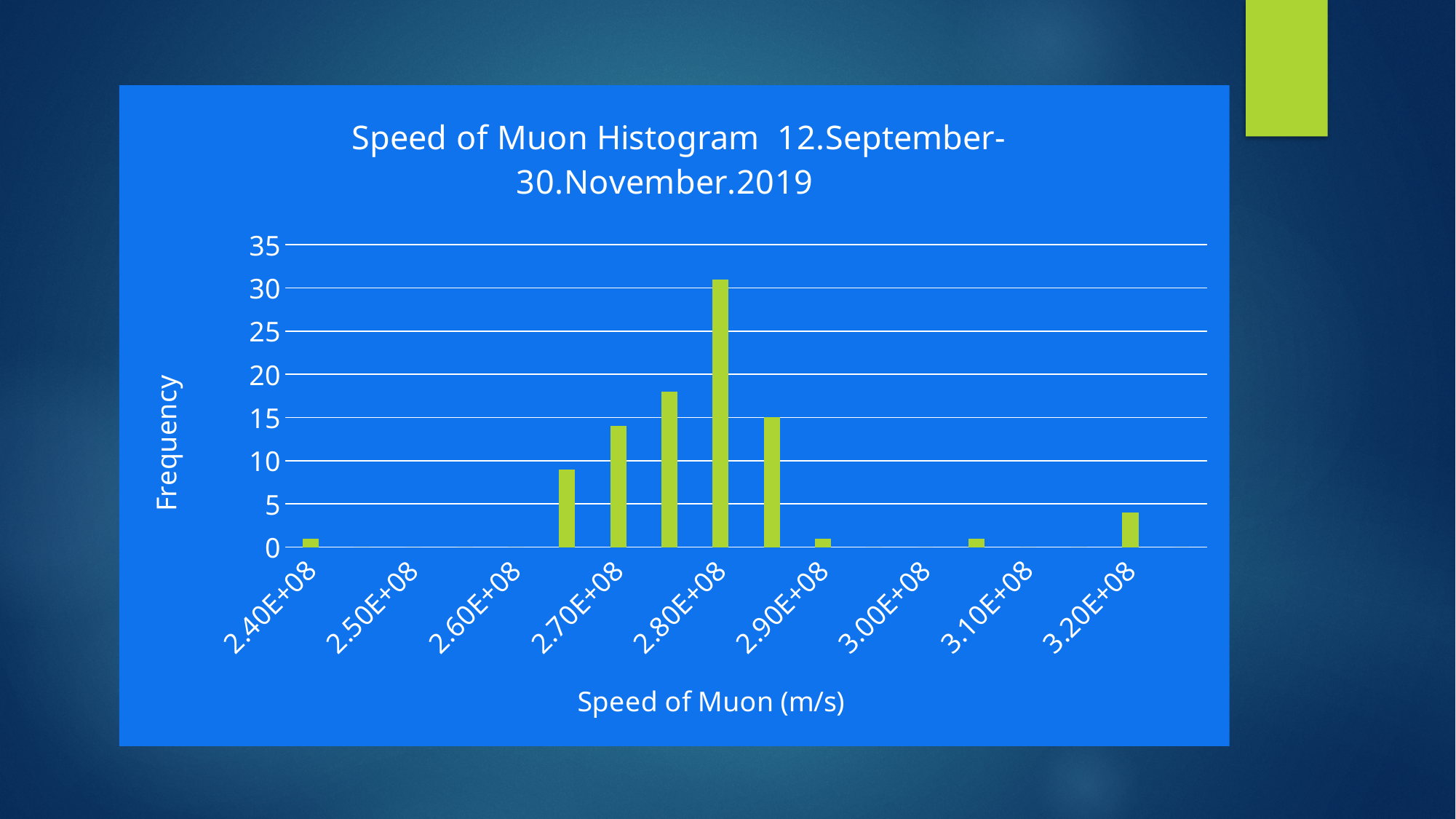
Which has a higher frequency, 2.70E+08 or 2.80E+08? 2.80E+08 What is the label of the vertical axis? Frequency Which has a higher frequency, 3.20E+08 or 2.40E+08? 3.20E+08 What kind of chart is shown on the slide? bar chart Which speed value has the highest frequency? 2.80E+08 How many bars are plotted in the chart? 9 Is the frequency for 2.70E+08 greater or less than 10? greater Is the frequency for 2.40E+08 greater or less than 5? less Is the frequency for 3.20E+08 greater or less than 10? less What is the title of the chart? Speed of Muon Histogram 12.September-30.November.2019